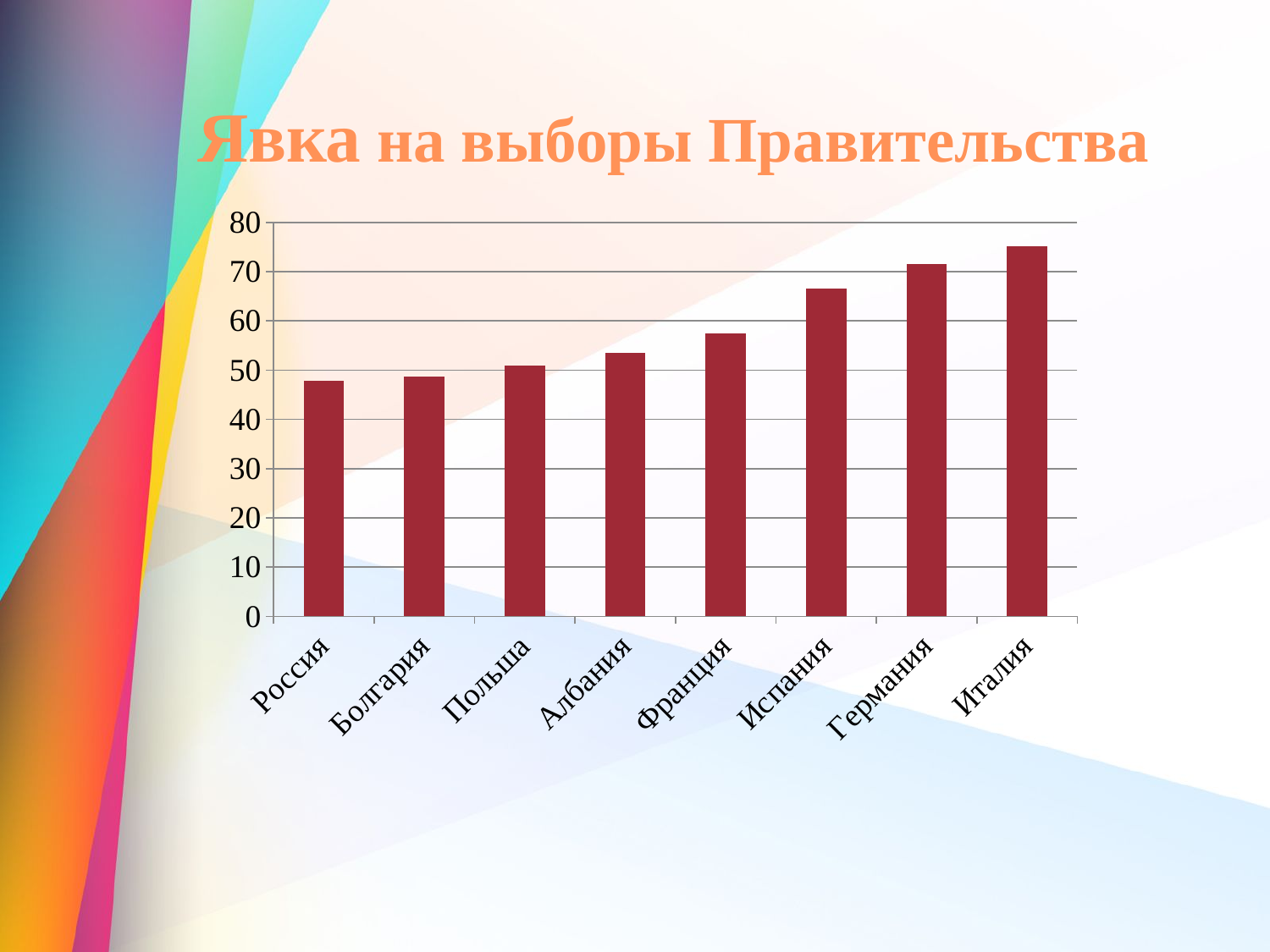
Which has the larger value, Испания or Франция? Испания Is the value for Италия greater or less than 70? greater How many countries are shown on the x axis of the chart? 8 Is the value for Франция greater or less than 60? less Is the value for Россия greater or less than 50? less Which has the larger value, Германия or Албания? Германия What kind of chart is shown on the slide? bar chart What is the title of the chart on the slide? Явка на выборы Правительства Do the bar values rise or fall from left to right along the x axis? rise Which country has the highest bar in the chart? Италия